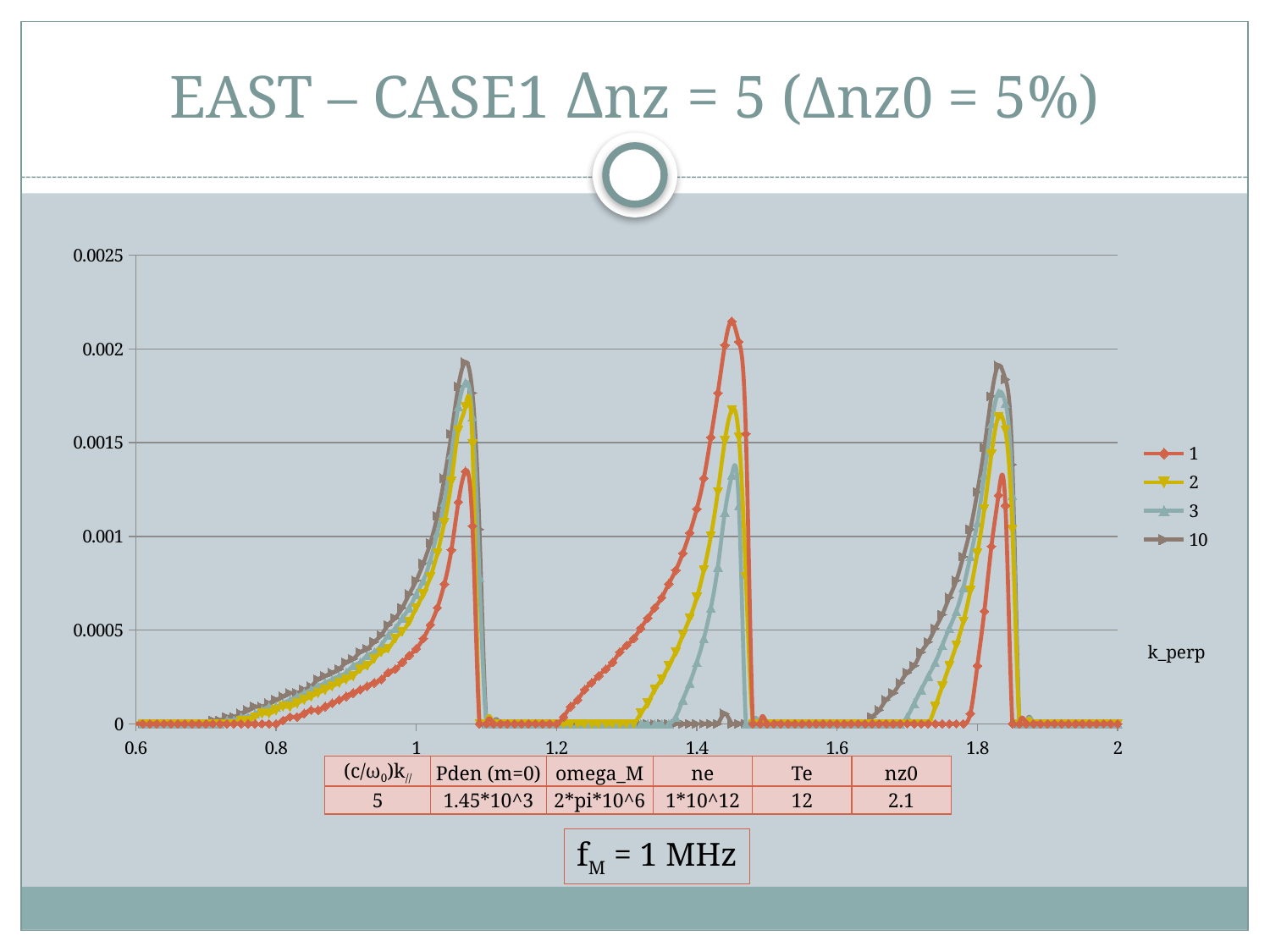
What are the series names listed in the legend? 1, 2, 3, 10 Which series reaches the highest value anywhere on the chart? 1 Is the peak of series 2 near x = 1.45 greater or less than 0.0015? greater Near x = 1.07, which series is higher: series 10 or series 1? 10 What kind of chart is shown on the slide? line chart What is the label shown next to the x axis? k_perp Is the peak of series 1 near x = 1.07 greater or less than 0.001? greater Near x = 1.45, which series is higher: series 1 or series 10? 1 How many series does the legend list? 4 Is the peak of series 3 near x = 1.45 greater or less than 0.0015? less